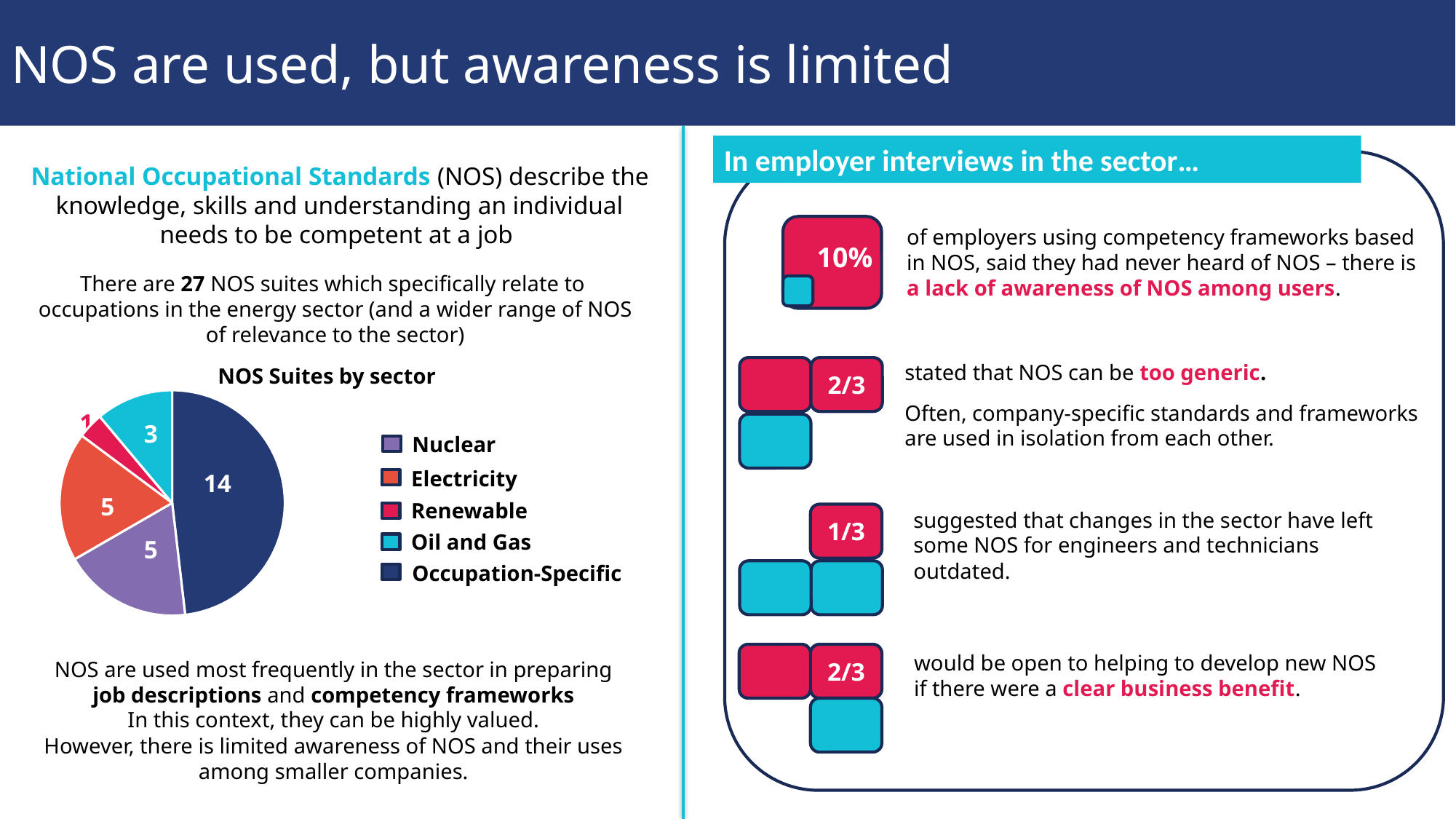
How many NOS suites are shown for Occupation-Specific? 14 What kind of chart is shown on the slide? pie chart Which sector has the smallest slice of the pie? Renewable What is the title of the chart? NOS Suites by sector Which sector has the largest slice of the pie? Occupation-Specific Which sector is shown in dark blue in the pie chart? Occupation-Specific How many sectors does the legend list? 5 Which is larger, the value for Oil and Gas or the value for Renewable? Oil and Gas How many NOS suites are shown for Nuclear? 5 How many NOS suites are shown for Renewable? 1 How many NOS suites are shown for Oil and Gas? 3 What is the difference between the Occupation-Specific value and the Oil and Gas value? 11